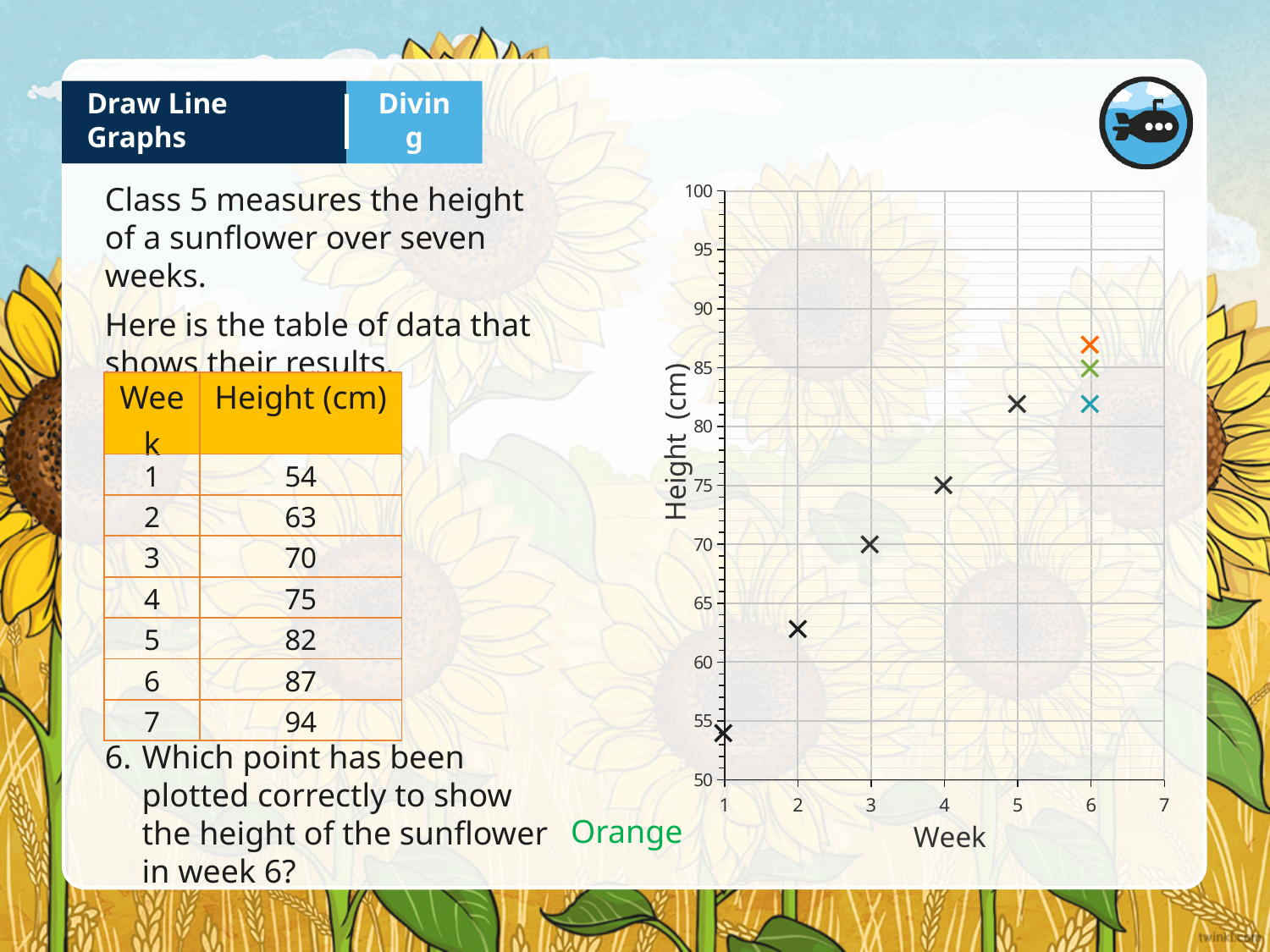
What height is plotted for week 4 on the chart? 75 Do the plotted heights rise or fall as the weeks increase? rise What is the difference between the plotted heights for week 4 and week 3? 5 What is the label on the x axis of the chart? Week Is the orange point at week 6 greater or less than 85? greater Is the plotted value for week 5 greater or less than 80? greater How many points are plotted at week 6 on the chart? 3 What height is plotted for week 3 on the chart? 70 Which week has the lowest plotted height on the chart? Week 1 What is the label on the y axis of the chart? Height (cm) Is the plotted value for week 1 greater or less than 55? less